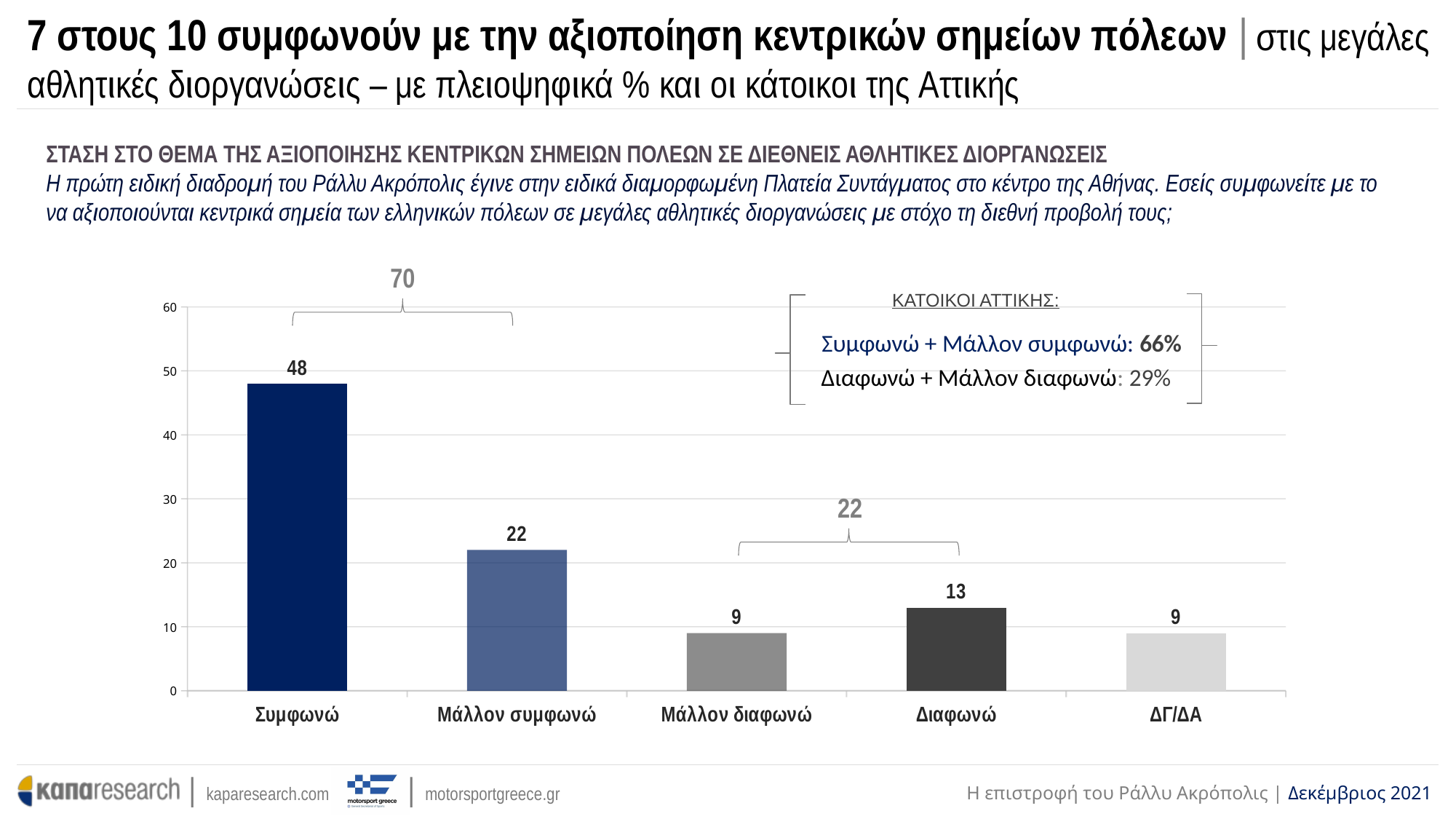
What is the value for Συμφωνώ? 48 Which category has the highest value? Συμφωνώ How many categories are shown on the x axis? 5 Is the value for Συμφωνώ greater or less than 40? greater What kind of chart is shown on the slide? bar chart Which is larger, the value for Διαφωνώ or the value for Μάλλον διαφωνώ? Διαφωνώ According to the box for ΚΑΤΟΙΚΟΙ ΑΤΤΙΚΗΣ, what is the value for Συμφωνώ + Μάλλον συμφωνώ? 66% What is the value for Μάλλον συμφωνώ? 22 What is the difference between the values for Συμφωνώ and Μάλλον συμφωνώ? 26 What is the value for Διαφωνώ? 13 What is the value for ΔΓ/ΔΑ? 9 What combined value is shown by the bracket above Συμφωνώ and Μάλλον συμφωνώ? 70